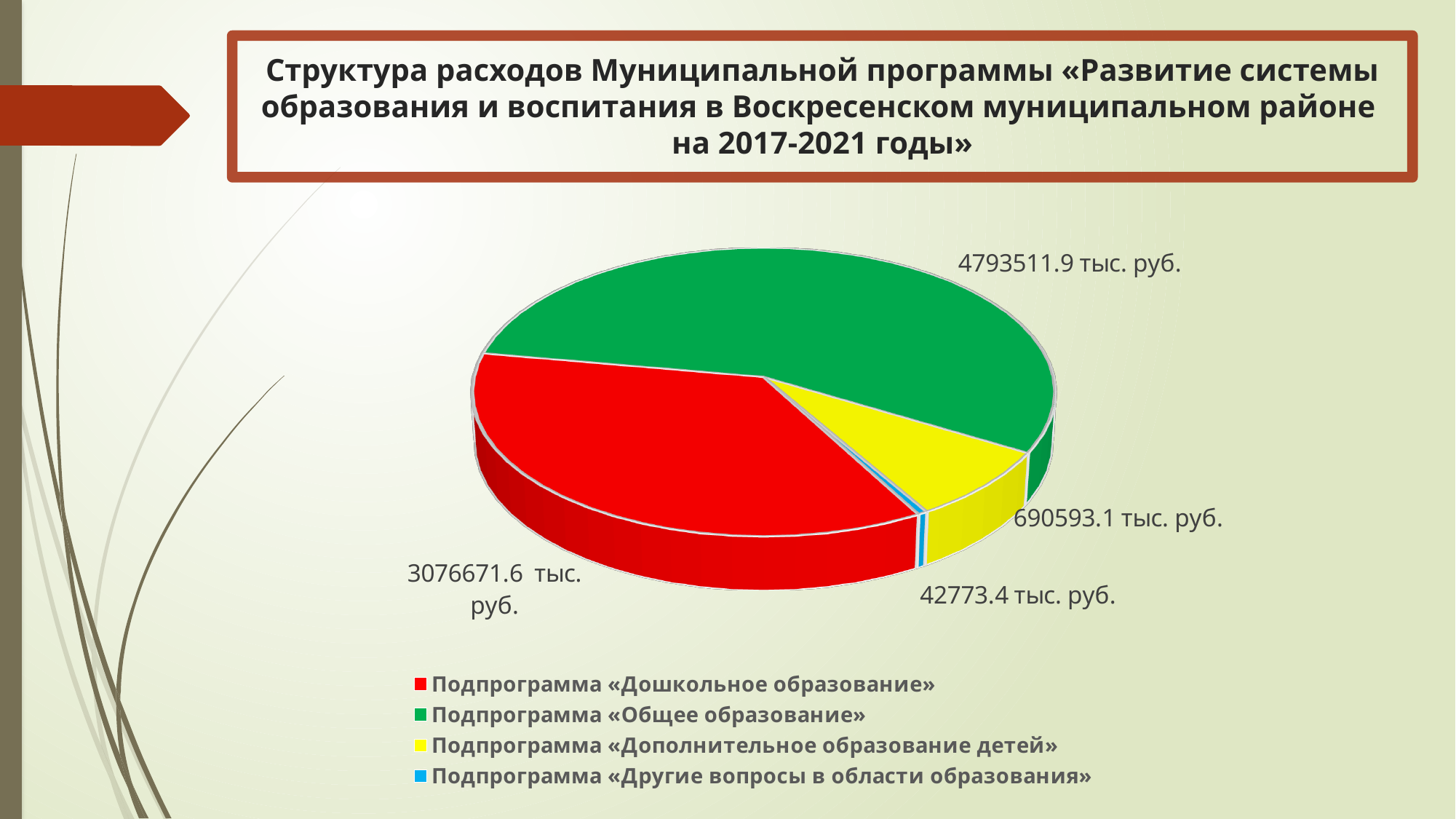
What is the value for Подпрограмма «Дошкольное образование»? 3076671.6 тыс. руб. Which is larger: the value for Подпрограмма «Дошкольное образование» or Подпрограмма «Дополнительное образование детей»? Подпрограмма «Дошкольное образование» How many slices does the pie chart have? 4 What is the value for Подпрограмма «Дополнительное образование детей»? 690593.1 тыс. руб. What is the value for Подпрограмма «Другие вопросы в области образования»? 42773.4 тыс. руб. How many entries does the legend list? 4 Which subprogram has the largest share of expenditure? Подпрограмма «Общее образование» Which subprogram has the smallest share of expenditure? Подпрограмма «Другие вопросы в области образования» What is the value for Подпрограмма «Общее образование»? 4793511.9 тыс. руб. What colour represents Подпрограмма «Дополнительное образование детей» in the chart? Yellow What kind of chart is shown on the slide? Pie chart What is the difference between the values for Подпрограмма «Общее образование» and Подпрограмма «Дошкольное образование»? 1716840.3 тыс. руб.